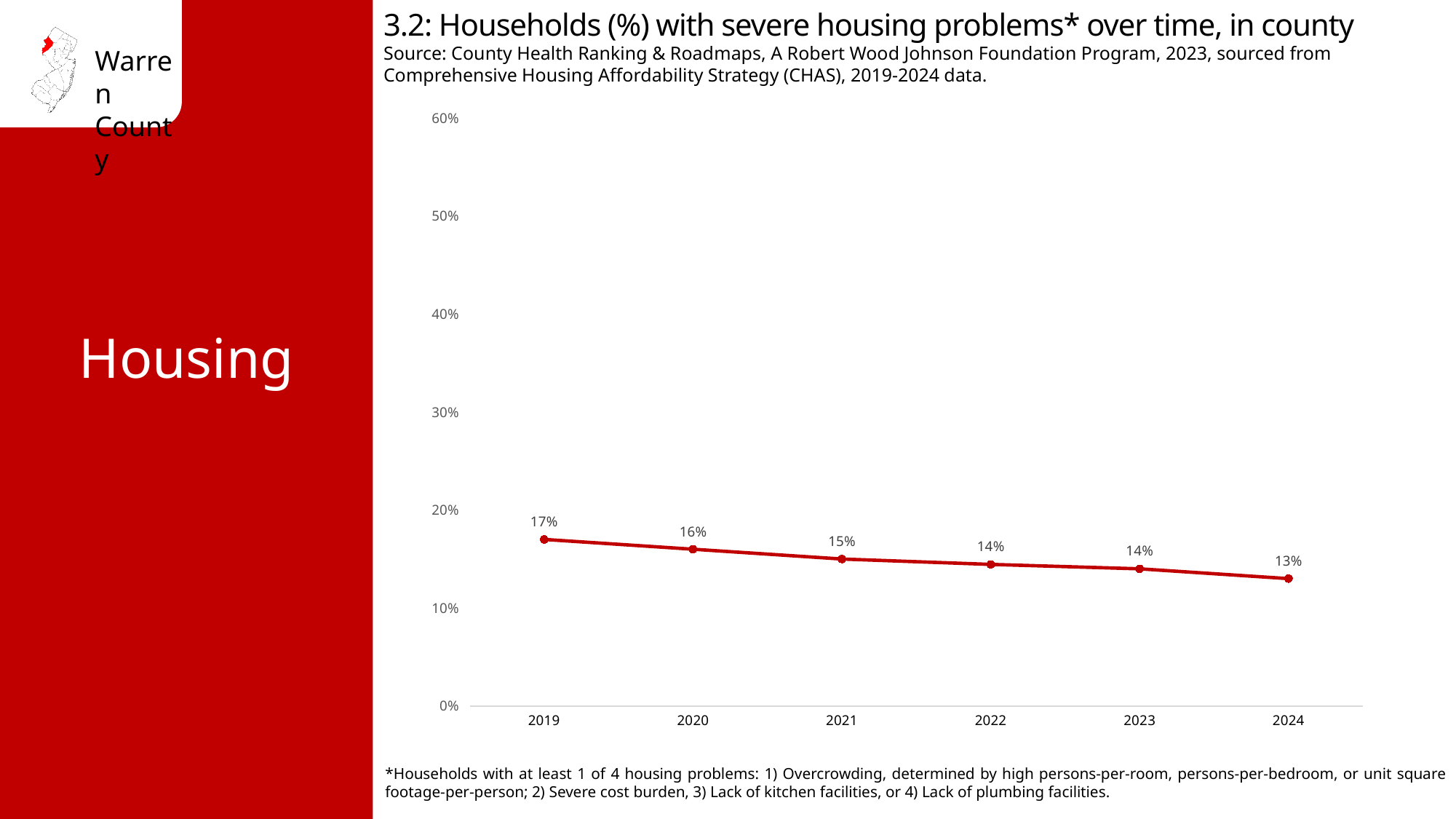
Do the values rise or fall from 2019 to 2024? fall What is the difference in percentage points between 2019 and 2024? 4 How many years are plotted on the chart? 6 What is the highest value shown on the vertical axis? 60% What percentage of households had severe housing problems in 2024? 13% What percentage of households had severe housing problems in 2019? 17% What is the value plotted for 2021? 15% Which year has the lowest percentage of households with severe housing problems? 2024 What kind of chart is shown on the slide? line chart Is the value for 2022 greater or less than 20%? less Which year has the highest percentage of households with severe housing problems? 2019 Which year has a higher value, 2020 or 2023? 2020